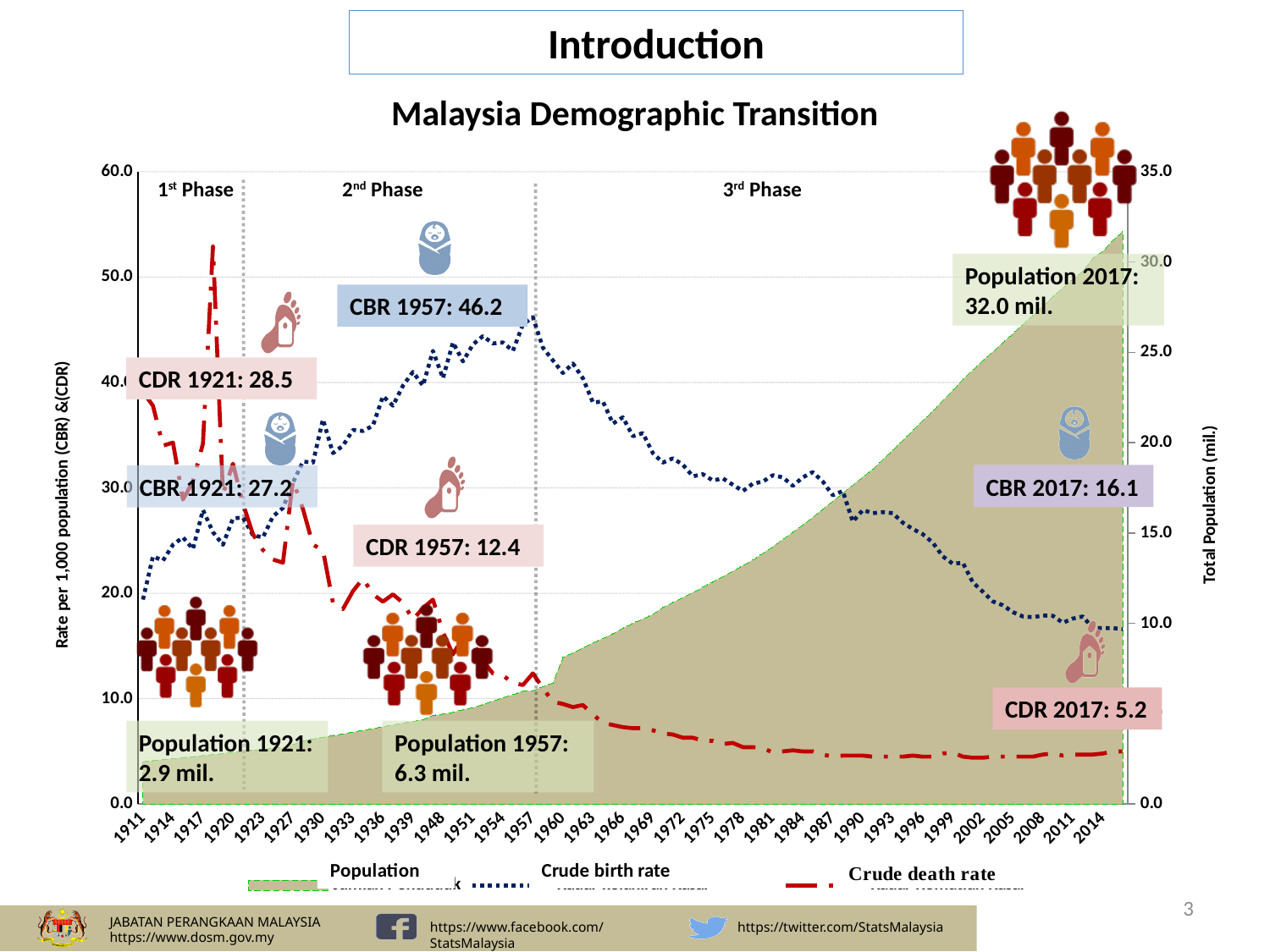
Does the population series rise or fall along the x axis from 1911 to 2014? Rise Which is larger: the CBR in 1921 or the CDR in 1921? CDR in 1921 Does the crude death rate rise or fall from 1921 to 2017? Fall What was Malaysia's population in 2017 according to the chart annotation? 32.0 mil. What is the title of the chart? Malaysia Demographic Transition What was the crude death rate (CDR) in 2017 according to the chart annotation? 5.2 How many phases are marked on the chart? 3 What was the crude birth rate (CBR) in 1957 according to the chart annotation? 46.2 What is the difference between the population in 1957 (6.3 mil.) and the population in 1921 (2.9 mil.)? 3.4 mil. How many series does the chart legend list? 3 What is the difference between the CBR in 1957 (46.2) and the CBR in 2017 (16.1)? 30.1 What was the crude death rate (CDR) in 1921 according to the chart annotation? 28.5